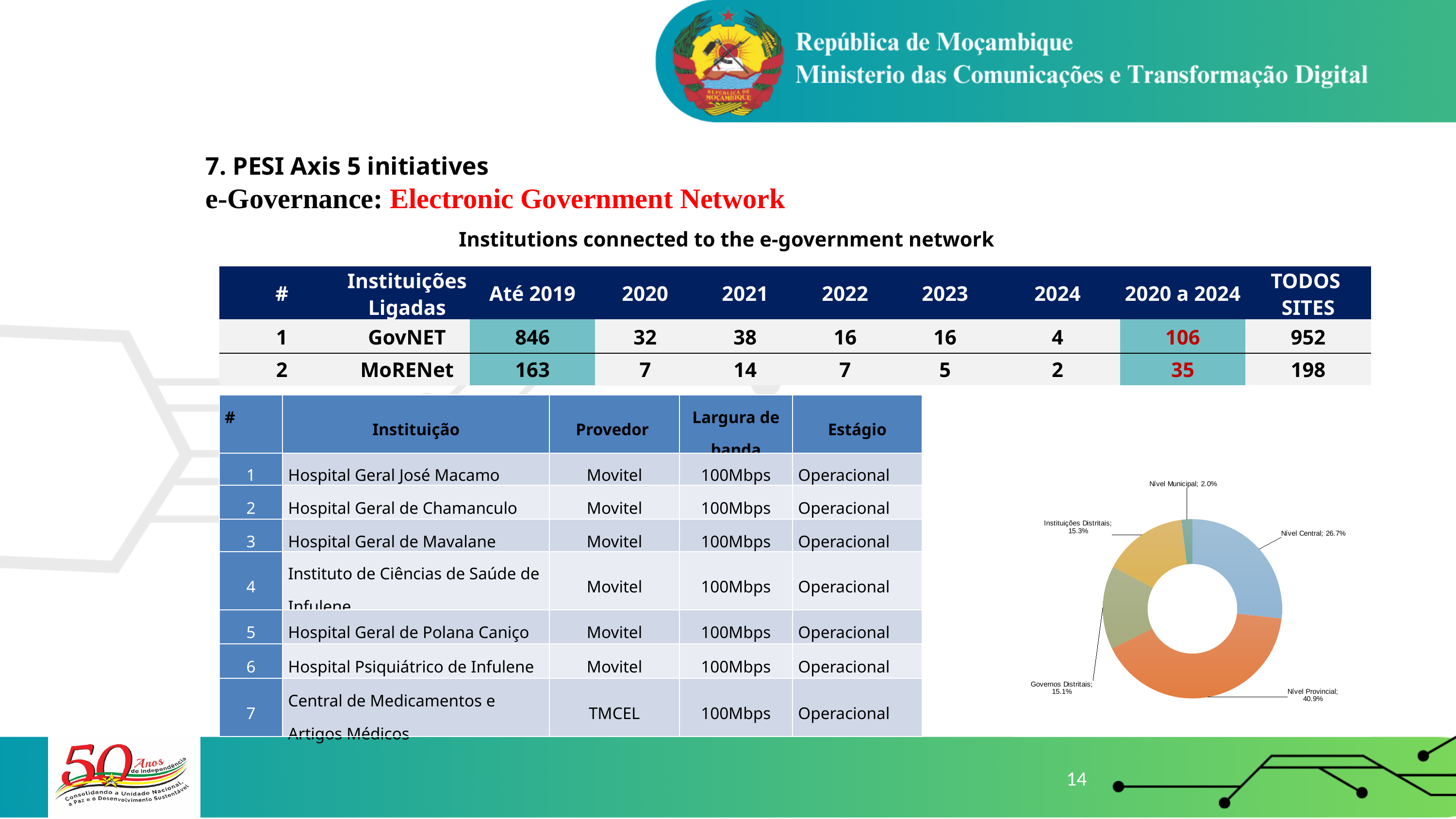
In the doughnut chart, what is the difference in percentage points between Nível Provincial and Nível Central? 14.2 In the doughnut chart, which category has the largest share? Nível Provincial In the doughnut chart, which category has the smallest share? Nível Municipal In the doughnut chart, what share is labelled for Instituições Distritais? 15.3% In the doughnut chart, what share is labelled for Nível Central? 26.7% In the doughnut chart, which is larger: the share for Nível Central or the share for Instituições Distritais? Nível Central What kind of chart is shown on the right side of the slide? Doughnut chart In the doughnut chart, what share is labelled for Nível Municipal? 2.0% In the doughnut chart, how many slices are there? 5 In the doughnut chart, what share is labelled for Nível Provincial? 40.9% In the doughnut chart, what colour is the Nível Provincial slice? Orange In the doughnut chart, what share is labelled for Governos Distritais? 15.1%